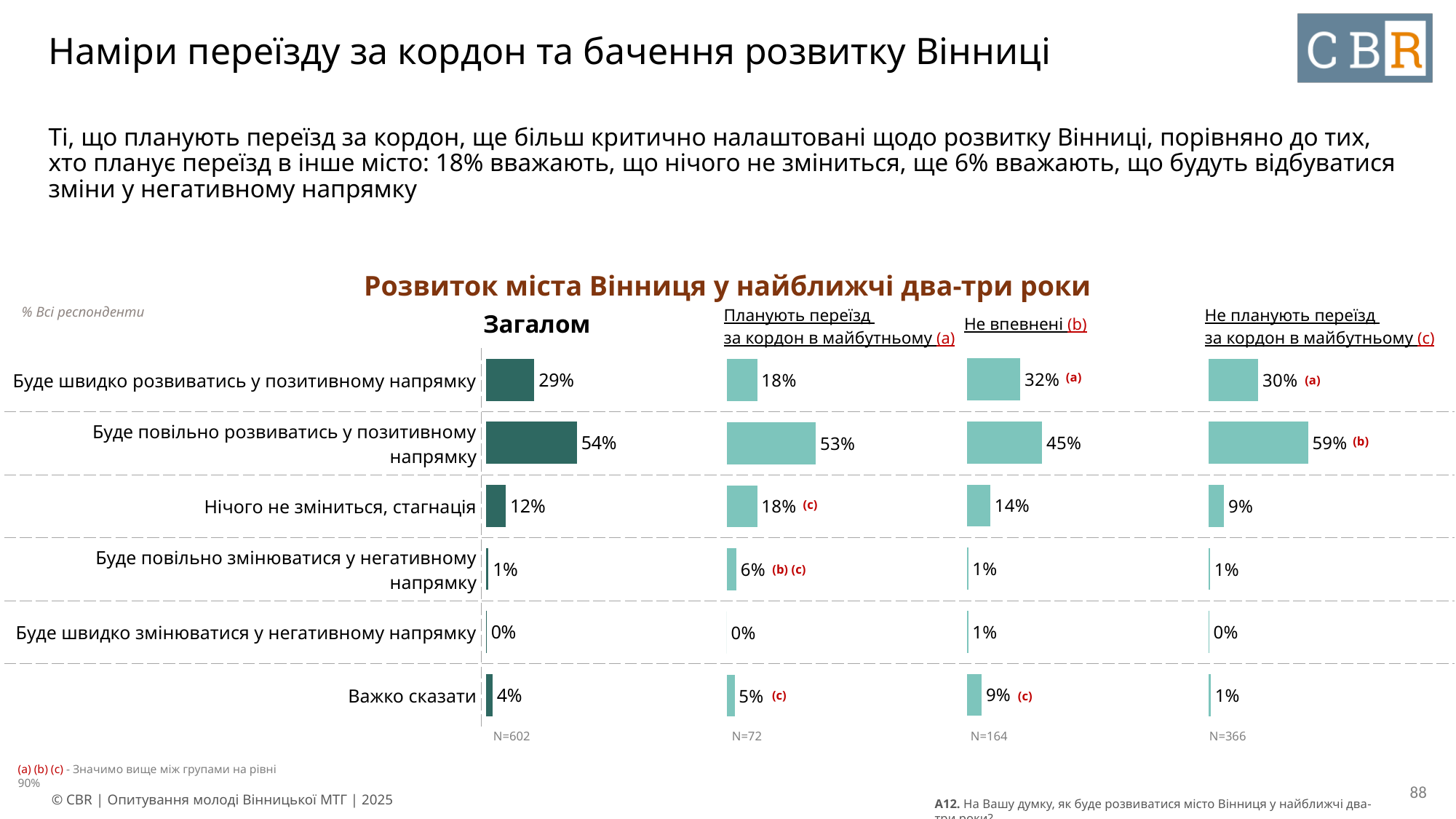
In the "Планують переїзд за кордон в майбутньому (a)" chart, what is the value for "Нічого не зміниться, стагнація"? 18% What is the sample size (N) shown under the "Не впевнені (b)" chart? N=164 Which is larger: the value for "Буде швидко розвиватись у позитивному напрямку" in the "Не впевнені (b)" chart or in the "Планують переїзд за кордон в майбутньому (a)" chart? Не впевнені (b) In the "Планують переїзд за кордон в майбутньому (a)" chart, what is the difference between "Буде повільно розвиватись у позитивному напрямку" and "Буде швидко розвиватись у позитивному напрямку"? 35% In the "Загалом" chart, what is the value for "Буде повільно розвиватись у позитивному напрямку"? 54% In the "Не планують переїзд за кордон в майбутньому (c)" chart, which category has the highest value? Буде повільно розвиватись у позитивному напрямку In the "Загалом" chart, which category has the lowest value? Буде швидко змінюватися у негативному напрямку What is the title shown above the four charts? Розвиток міста Вінниця у найближчі два-три роки How many categories are shown in the "Загалом" chart? 6 What type of chart is used for the "Загалом" data? Bar chart In the "Не впевнені (b)" chart, what is the value for "Важко сказати"? 9% In the "Не планують переїзд за кордон в майбутньому (c)" chart, what is the value for "Нічого не зміниться, стагнація"? 9%